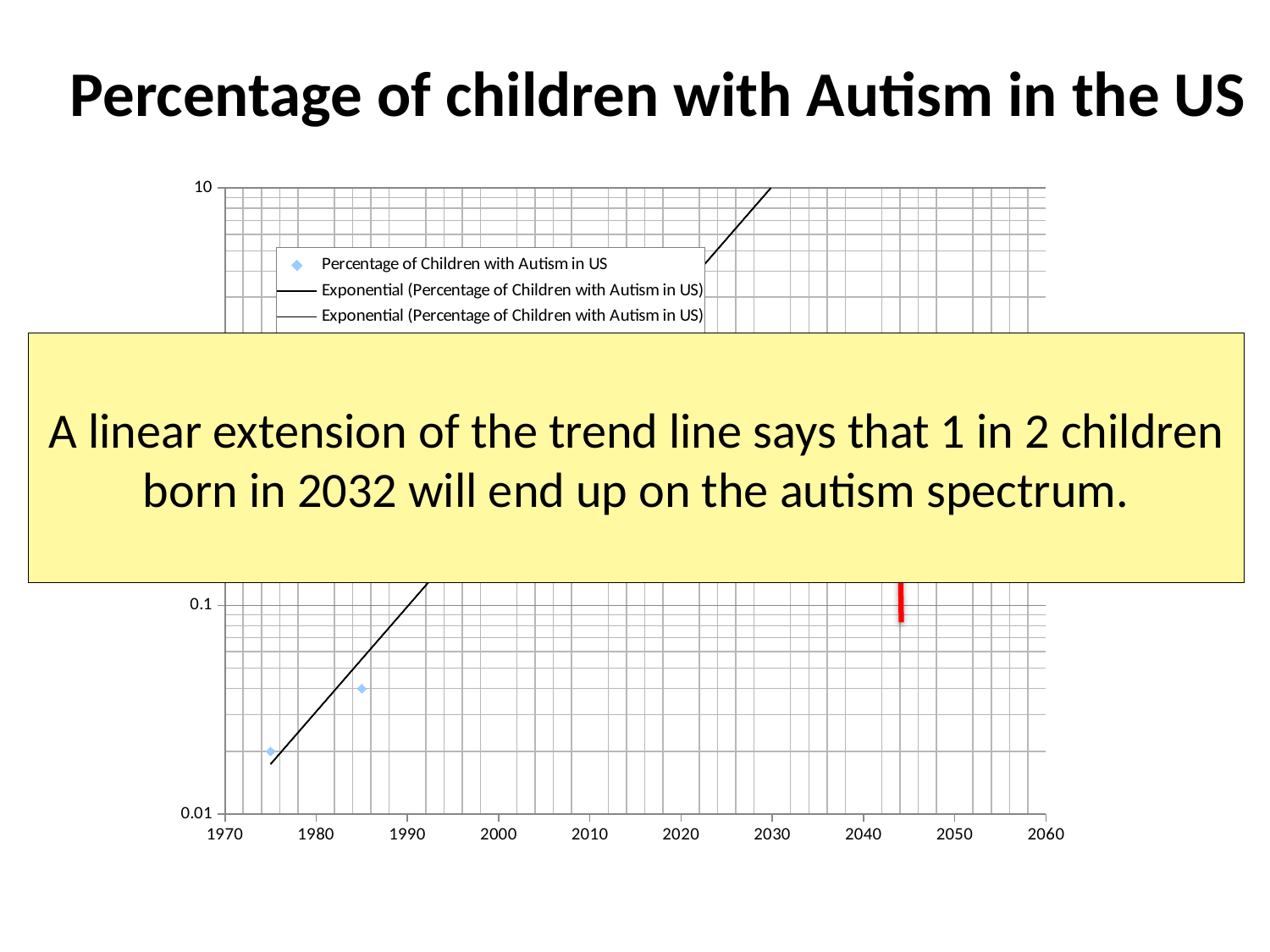
Is the plotted value for 1985 greater or less than 0.1? less Is the plotted value for 1975 greater or less than 0.01? greater What is the highest value labelled on the y axis? 10 What is the title of the slide's chart? Percentage of children with Autism in the US What kind of chart is shown on the slide? Scatter chart with a trend line Is the plotted value for 1975 greater or less than 0.1? less Do the plotted values rise or fall as the years increase along the x axis? rise Which has the larger plotted value, 1975 or 1985? 1985 What is the lowest value labelled on the y axis? 0.01 How many entries does the chart's legend list? 3